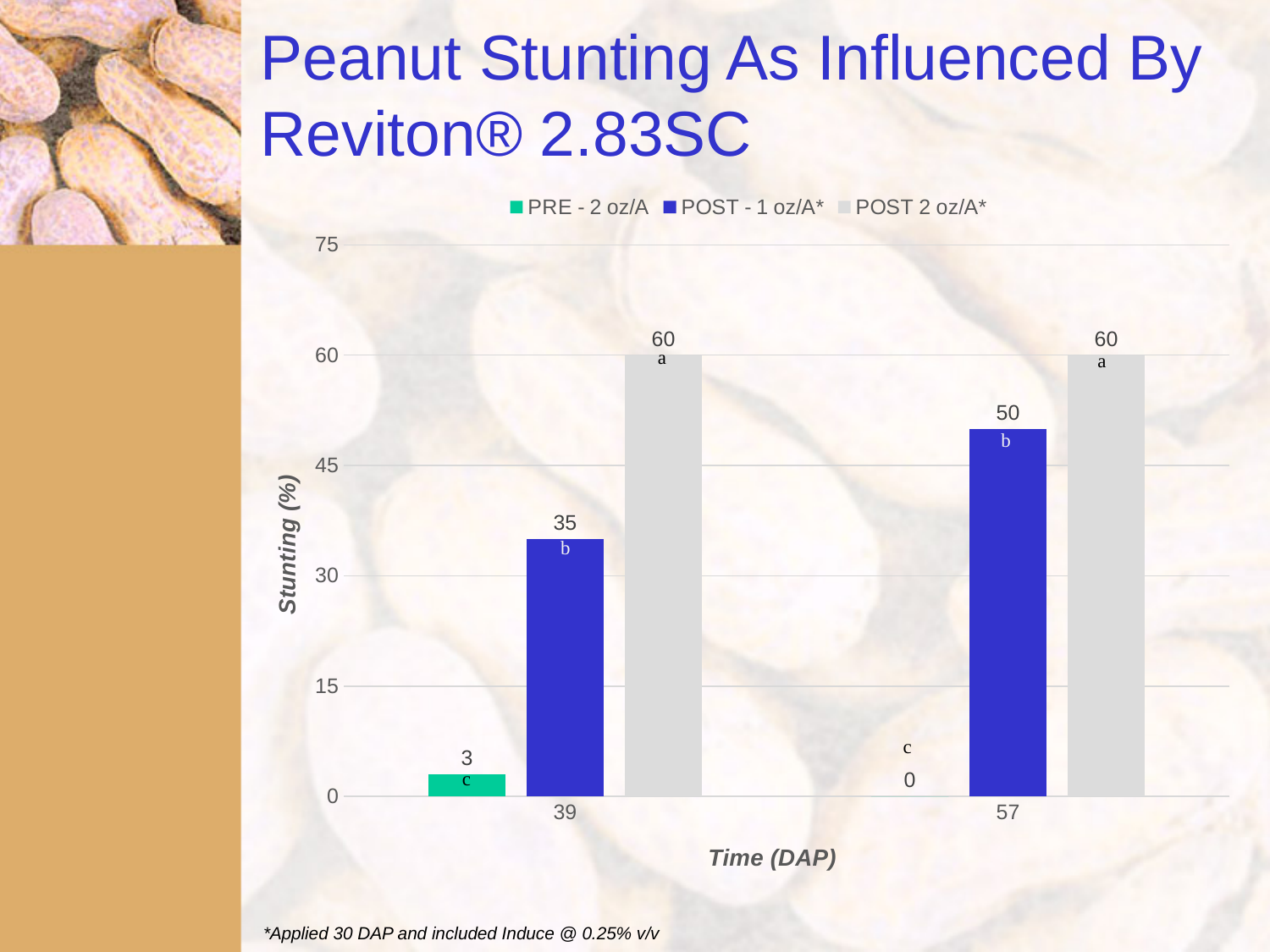
What kind of chart is shown on the slide? Bar chart What is the label of the y axis? Stunting (%) What is the difference between the POST 2 oz/A* and POST - 1 oz/A* values at 39 DAP? 25 What is the difference between the POST - 1 oz/A* values at 57 DAP and 39 DAP? 15 Which series has the highest stunting value at 39 DAP? POST 2 oz/A* What is the stunting value for PRE - 2 oz/A at 57 DAP? 0 Which is larger: POST - 1 oz/A* at 39 DAP or POST - 1 oz/A* at 57 DAP? POST - 1 oz/A* at 57 DAP What is the stunting value for POST 2 oz/A* at 39 DAP? 60 Which series has the lowest stunting value at 57 DAP? PRE - 2 oz/A How many series does the legend list? 3 What is the stunting value for PRE - 2 oz/A at 39 DAP? 3 What is the stunting value for POST - 1 oz/A* at 57 DAP? 50